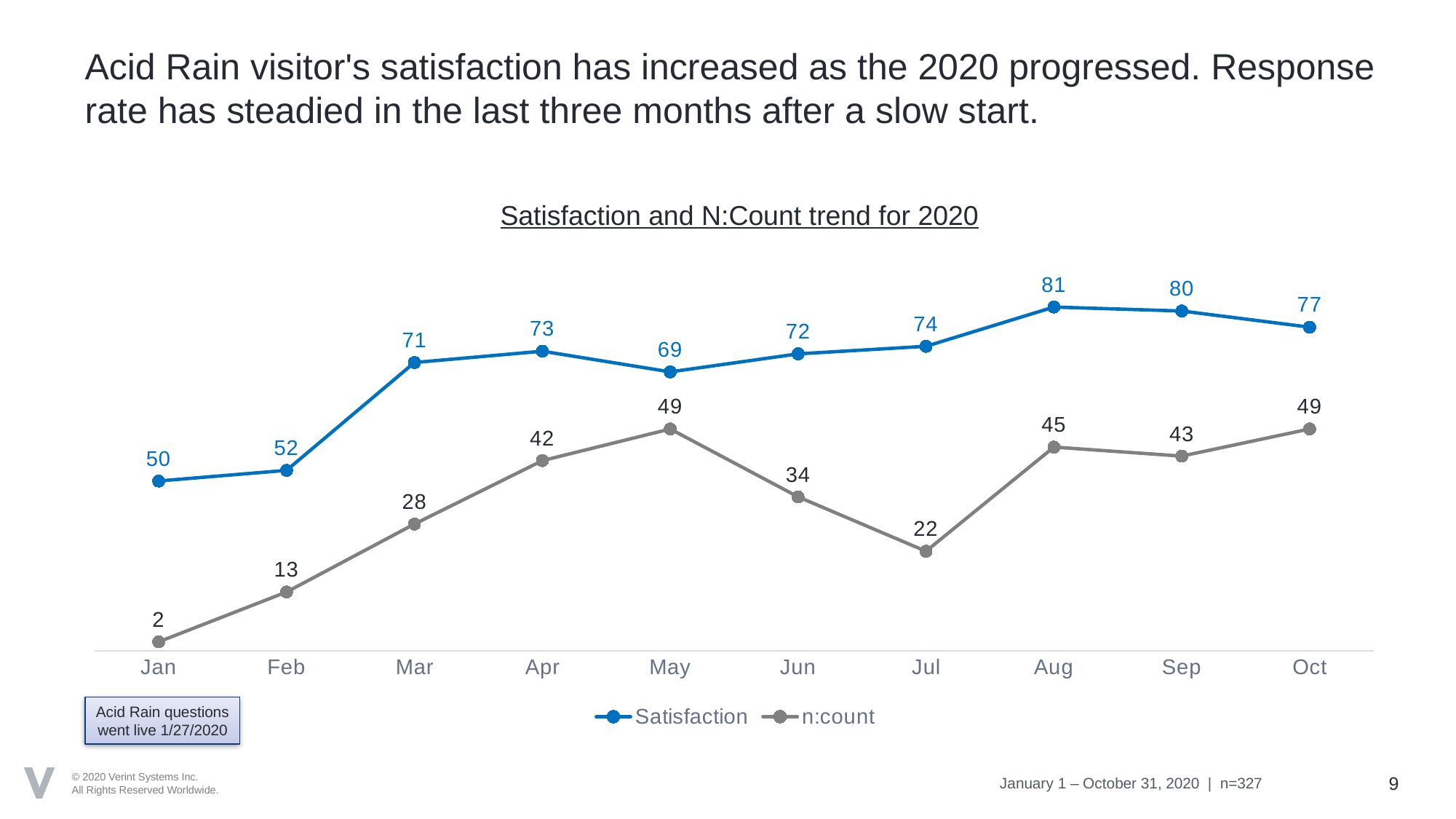
What is the n:count value for May? 49 Does the Satisfaction series rise or fall from Jan to Mar? Rise Which is larger, the n:count for Jun or the n:count for Jul? Jun How many months are plotted on the x axis? 10 What kind of chart is shown on the slide? Line chart Which month has the highest Satisfaction value? Aug What is the Satisfaction value for Aug? 81 Which month has the lowest n:count value? Jan What is the title of the chart? Satisfaction and N:Count trend for 2020 What is the difference between the Satisfaction values for Aug and Jan? 31 What is the Satisfaction value for Jan? 50 How many series does the legend list? 2